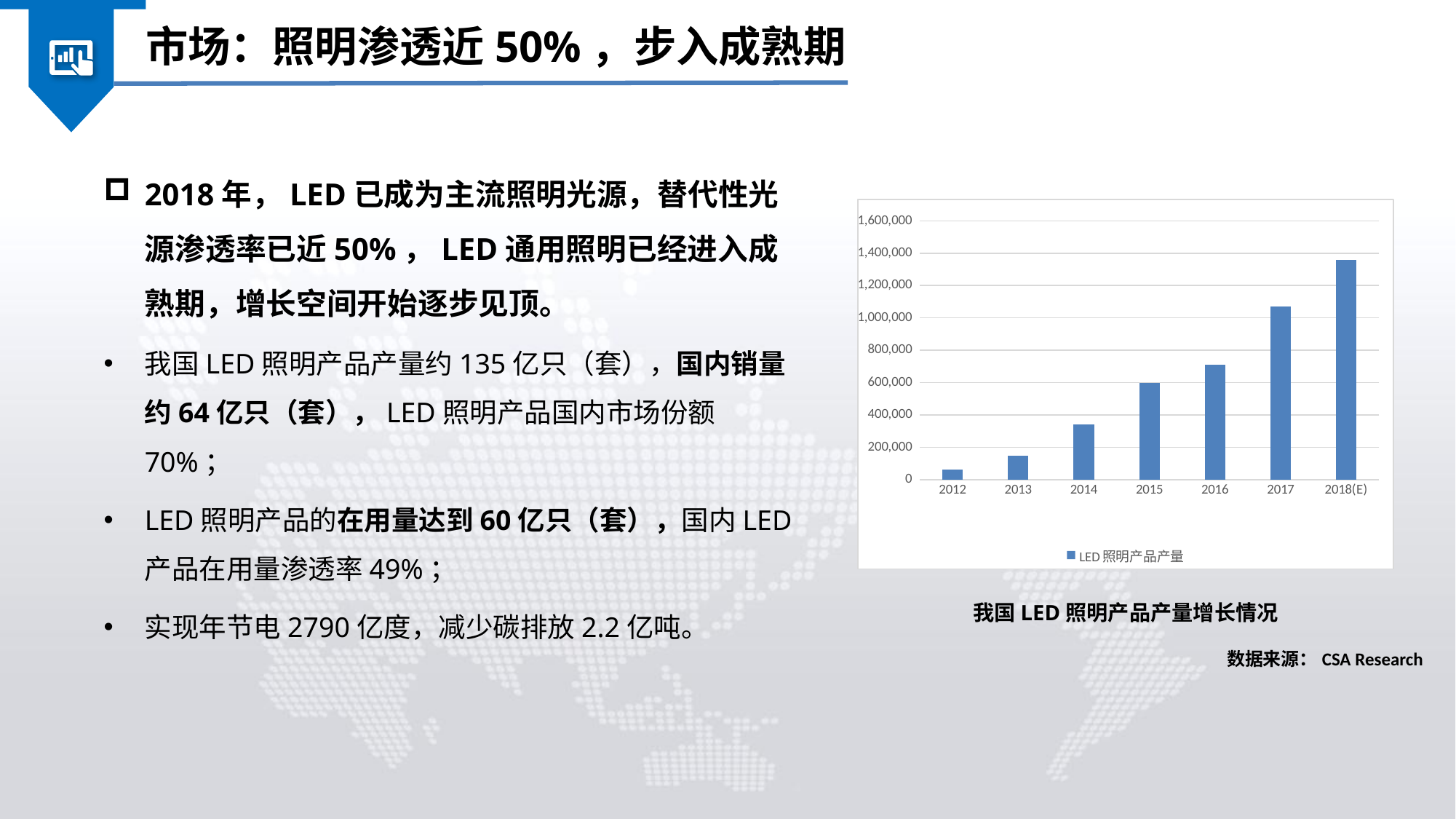
Is the value for 2018(E) greater or less than 1,400,000? less What is the name of the series shown in the chart legend? LED 照明产品产量 Which year has the highest LED 照明产品产量 in the chart? 2018(E) Which is larger, the value for 2017 or the value for 2015? 2017 Do the values in the chart rise or fall from 2012 to 2018(E)? rise Is the value for 2012 greater or less than 200,000? less Is the value for 2017 greater or less than 1,000,000? greater Which year has the lowest LED 照明产品产量 in the chart? 2012 What kind of chart is shown on the slide? bar chart How many years (categories) are shown on the x axis of the chart? 7 How many series does the chart legend list? 1